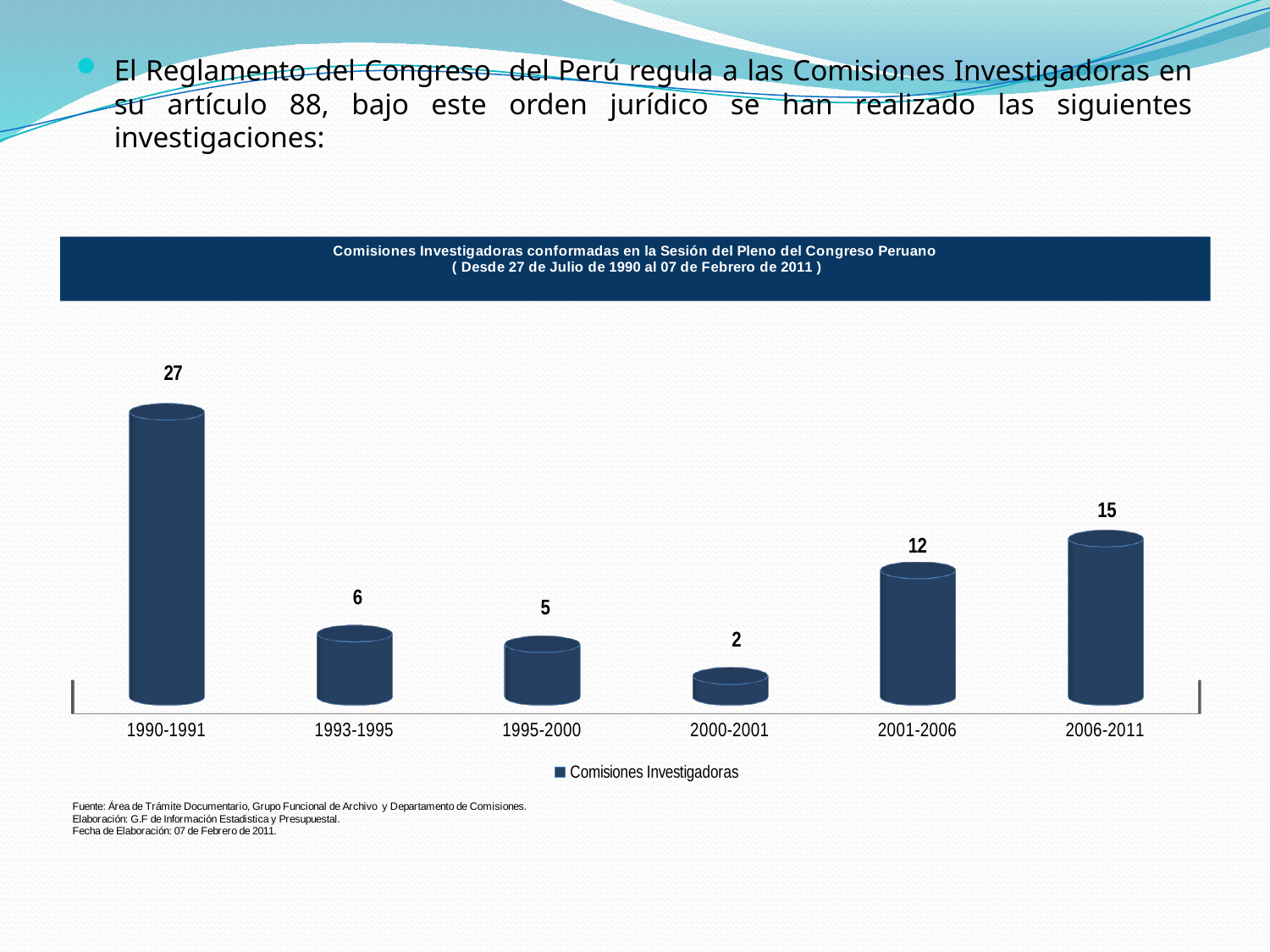
Which period has the highest number of Comisiones Investigadoras? 1990-1991 How many periods (categories) are shown on the x axis? 6 What is the difference between the values for 2001-2006 and 1995-2000? 7 What is the difference between the values for 1990-1991 and 2006-2011? 12 How many Comisiones Investigadoras were formed in the 1990-1991 period? 27 Which period has the lowest number of Comisiones Investigadoras? 2000-2001 How many series does the legend list? 1 What is the value shown for the 2006-2011 period? 15 What is the value shown for the 2000-2001 period? 2 What is the legend entry shown below the chart? Comisiones Investigadoras What kind of chart is shown on the slide? Bar chart Which is larger, the value for 1993-1995 or the value for 1995-2000? 1993-1995